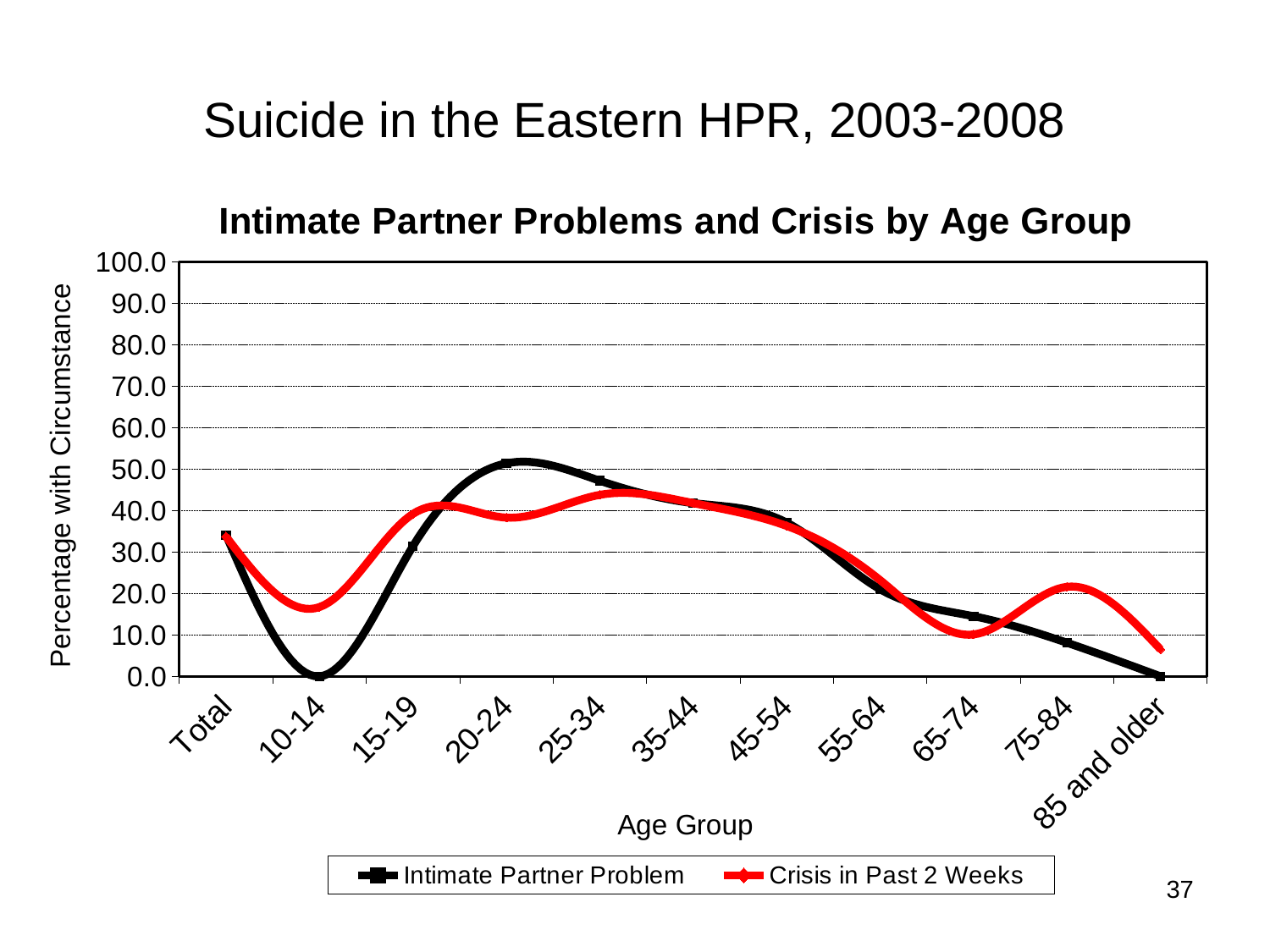
In the 20-24 age group, which series has the larger value, Intimate Partner Problem or Crisis in Past 2 Weeks? Intimate Partner Problem What is the value for Intimate Partner Problem in the 85 and older age group? 0.0 Which age group has the highest value for Intimate Partner Problem? 20-24 Which series is drawn in red? Crisis in Past 2 Weeks What is the value for Intimate Partner Problem in the 10-14 age group? 0.0 Is the value for Crisis in Past 2 Weeks in the 65-74 age group greater or less than 20.0? less How many age group categories are shown on the x axis? 11 What is the title of the chart? Intimate Partner Problems and Crisis by Age Group How many series does the legend list? 2 In the 75-84 age group, which series has the larger value, Intimate Partner Problem or Crisis in Past 2 Weeks? Crisis in Past 2 Weeks What kind of chart is shown on the slide? line chart Is the value for Intimate Partner Problem in the 20-24 age group greater or less than 40.0? greater